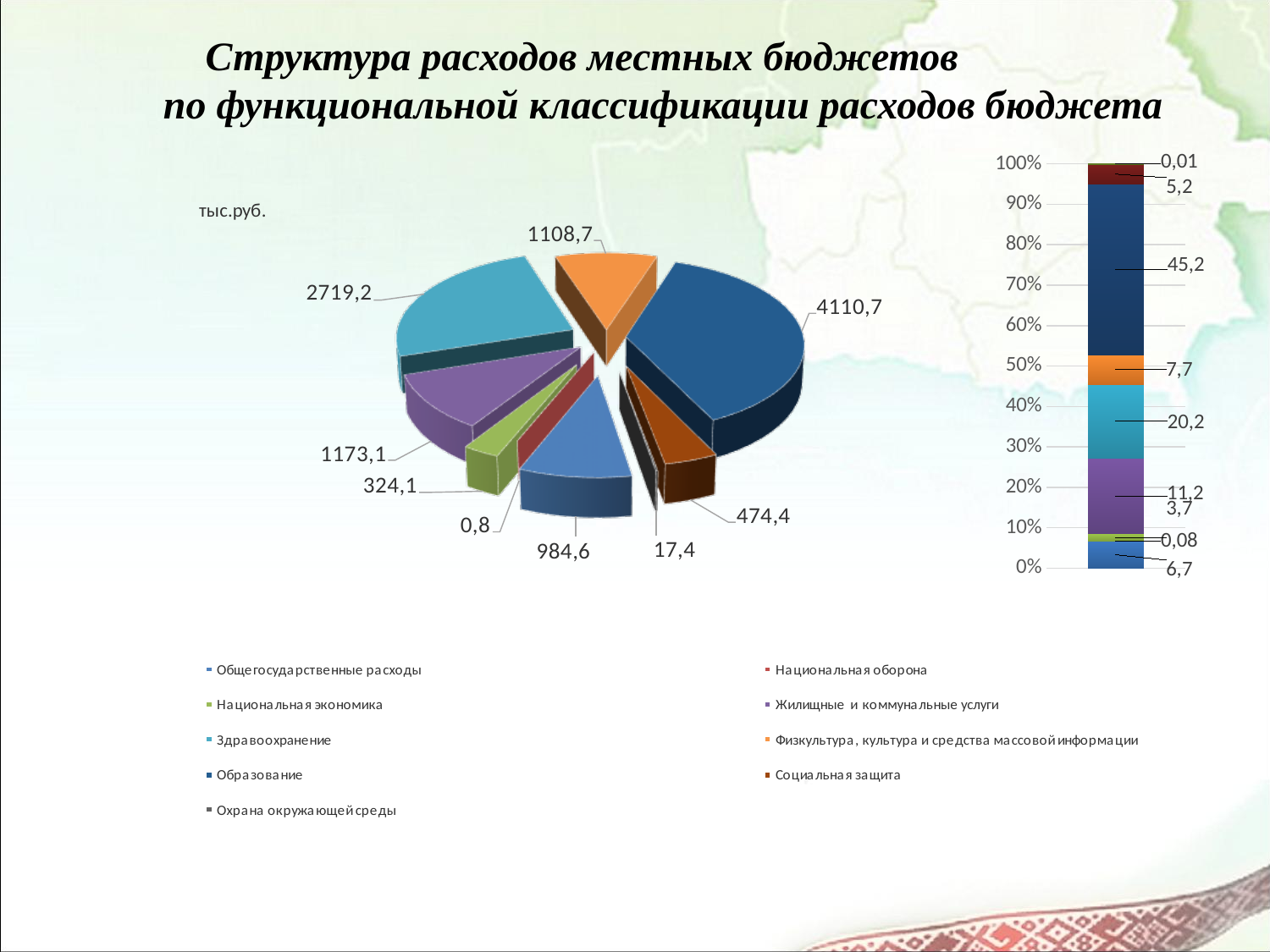
In the pie chart, what is the value for Здравоохранение? 2719,2 What unit is shown above the pie chart? тыс.руб. In the pie chart, which category has the smallest slice? Национальная оборона In the pie chart, which category has the largest slice? Образование How many categories does the legend list? 9 What kind of chart is the chart on the right of the slide with the percentage axis? stacked bar chart In the pie chart, what is the value for Образование? 4110,7 In the pie chart, what is the value for Физкультура, культура и средства массовой информации? 1108,7 In the pie chart, which is larger: Жилищные и коммунальные услуги or Физкультура, культура и средства массовой информации? Жилищные и коммунальные услуги What kind of chart is the chart on the left of the slide? pie chart In the stacked bar chart on the right, what is the value of the largest segment? 45,2 In the pie chart, what is the difference between the values for Образование and Здравоохранение? 1391,5